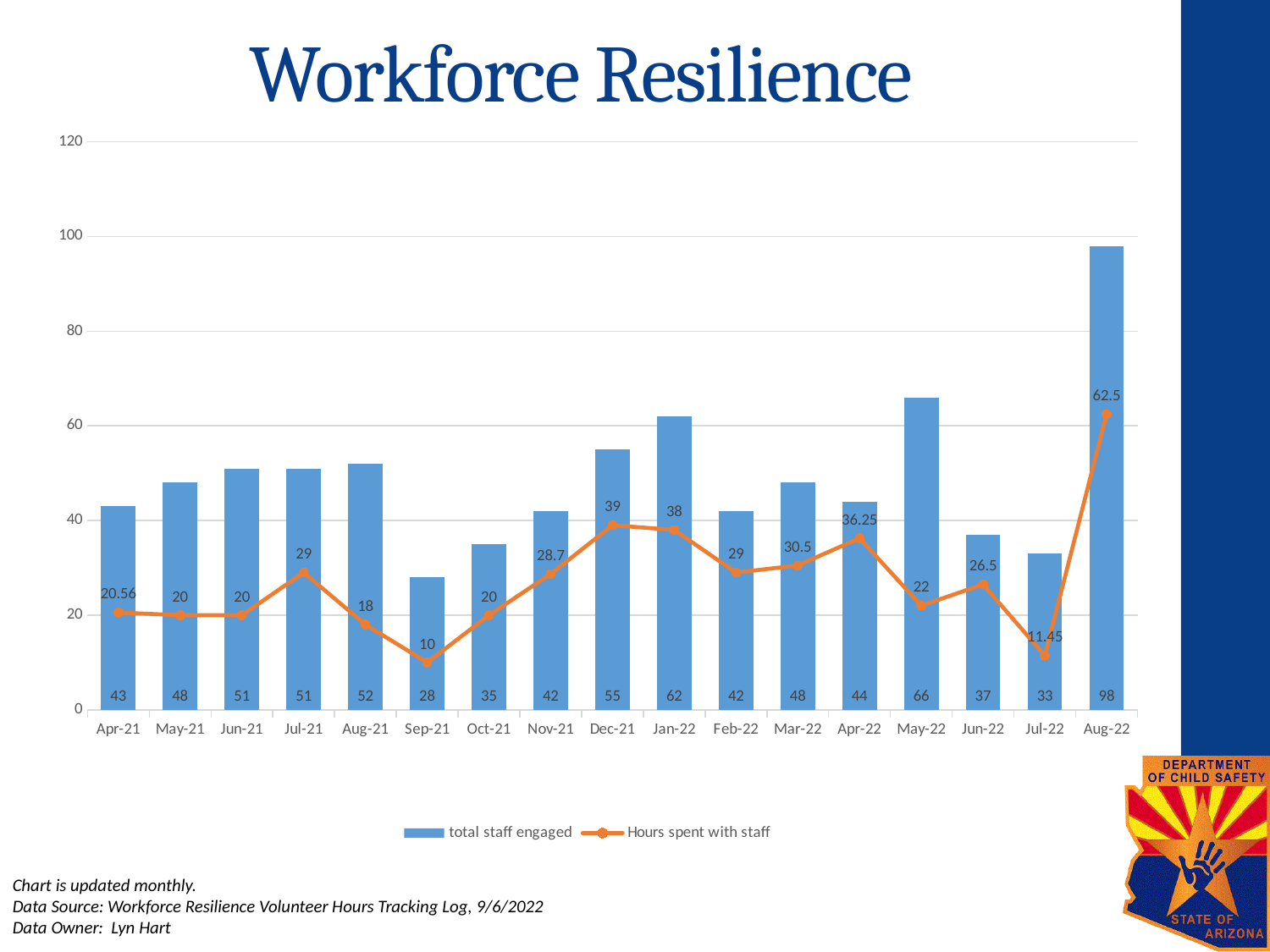
How many months are shown on the x axis? 17 How many series does the legend list? 2 Which is larger, total staff engaged in Dec-21 or in Jan-22? Jan-22 Which month has the highest total staff engaged? Aug-22 What kind of chart is used for the 'total staff engaged' series? Bar chart How many hours were spent with staff in Apr-21? 20.56 What is the difference in total staff engaged between Aug-22 and May-22? 32 What is the value of Hours spent with staff for Jul-22? 11.45 Which month has the lowest Hours spent with staff? Sep-21 What is the title of the chart? Workforce Resilience What is the value of total staff engaged for Aug-22? 98 What is the difference in Hours spent with staff between Aug-22 and Jul-22? 51.05